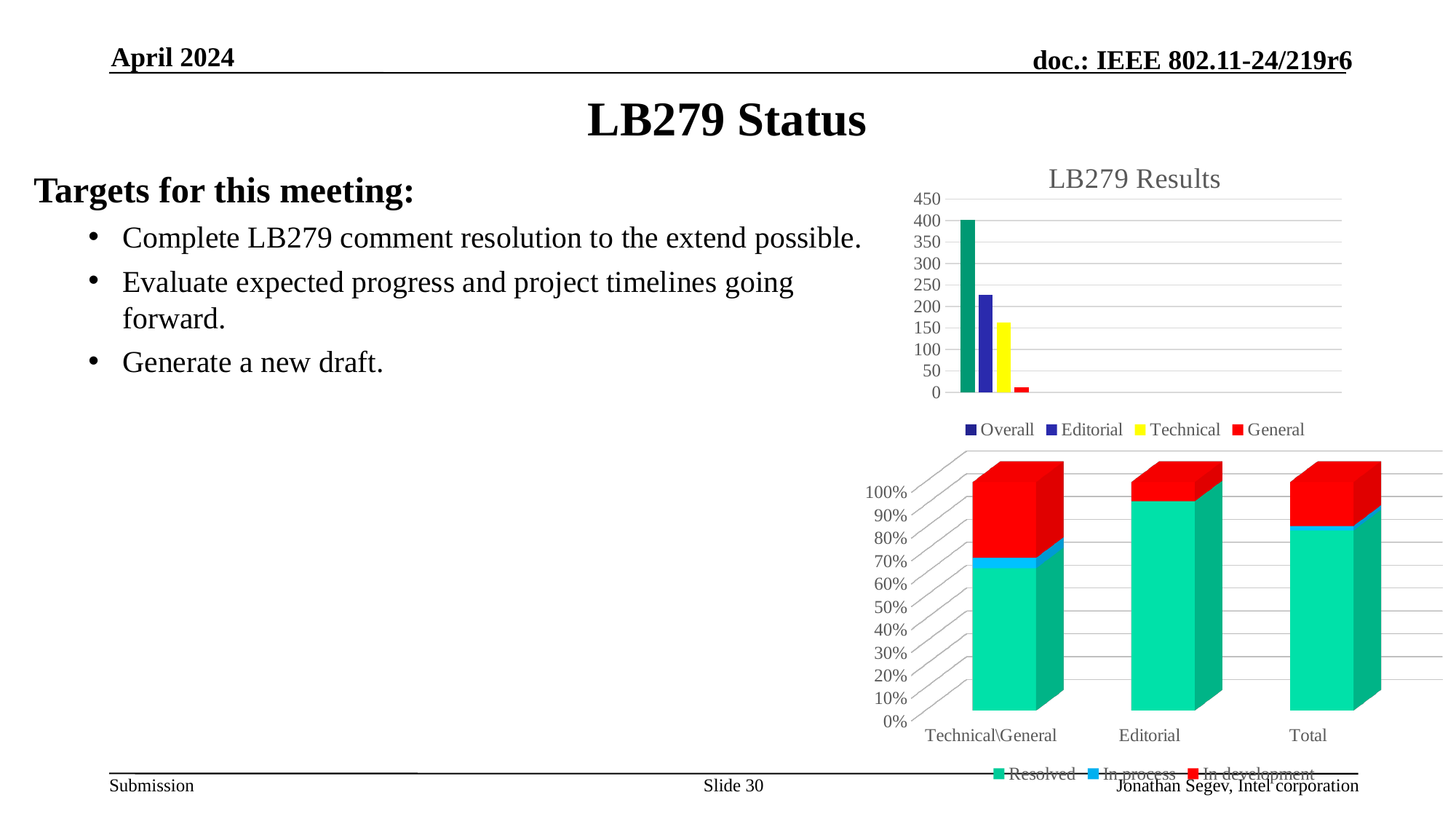
In the LB279 Results chart, which is larger, Editorial or Technical? Editorial In the LB279 Results chart, is the value for Editorial greater or less than 200? greater In the LB279 Results chart, which series has the lowest value? General In the LB279 Results chart, is the value for Overall greater or less than 350? greater In the LB279 Results chart, which series has the highest value? Overall In the LB279 Results chart, what type of chart is shown? bar chart In the LB279 Results chart, is the value for Technical greater or less than 200? less In the bottom stacked chart, how many categories are shown on the x axis? 3 In the bottom stacked chart, how many series does the legend list? 3 In the LB279 Results chart, how many series does the legend list? 4